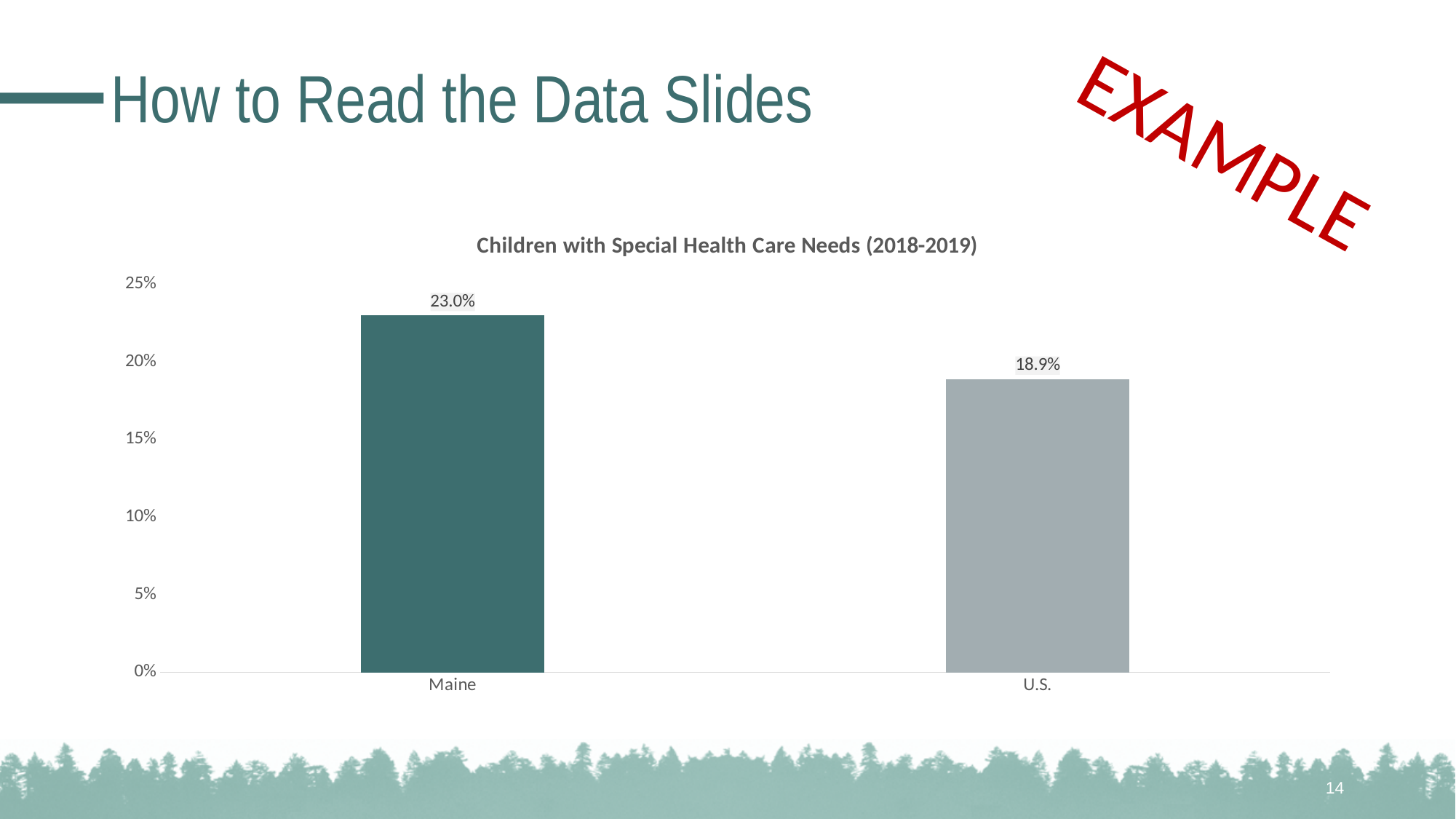
What is the difference between the values for Maine and U.S.? 4.1% Which is larger, the value for Maine or the value for U.S.? Maine What is the value for U.S.? 18.9% What is the highest value shown on the vertical axis? 25% What is the title of the chart? Children with Special Health Care Needs (2018-2019) Is the value for U.S. greater or less than 20%? less What is the value for Maine? 23.0% Is the value for Maine greater or less than 20%? greater What kind of chart is shown on the slide? bar chart How many categories are shown on the chart? 2 Which category has the highest value? Maine Which category has the lowest value? U.S.